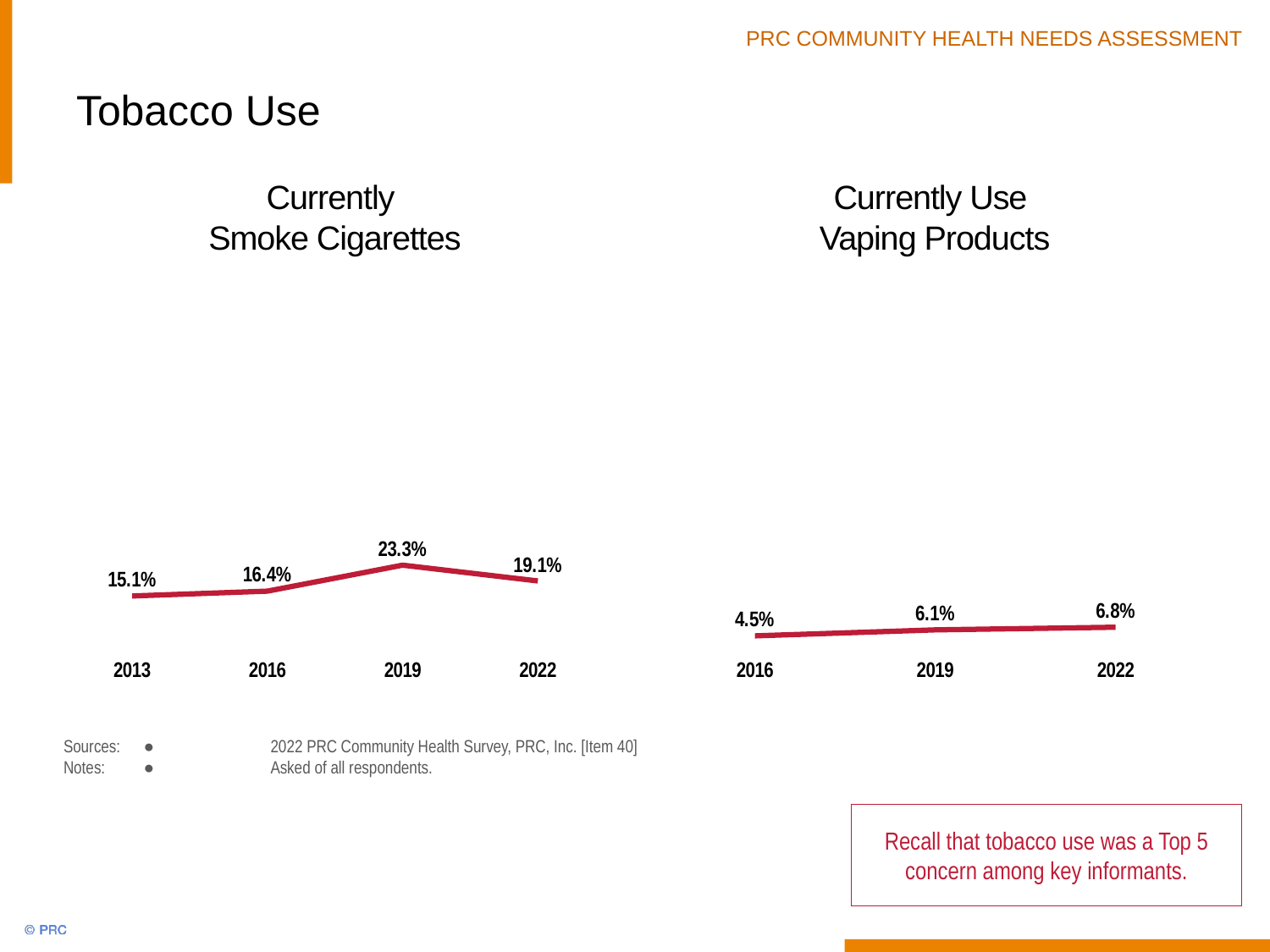
In the 'Currently Smoke Cigarettes' chart, what is the value for 2019? 23.3% In the 'Currently Smoke Cigarettes' chart, what is the value for 2013? 15.1% What kind of chart is the 'Currently Use Vaping Products' chart? Line chart In the 'Currently Use Vaping Products' chart, what is the difference between the 2022 and 2016 values? 2.3% In the 'Currently Smoke Cigarettes' chart, what is the difference between the 2019 and 2022 values? 4.2% In the 'Currently Use Vaping Products' chart, which year has the lowest value? 2016 How many years are plotted in the 'Currently Smoke Cigarettes' chart? 4 In the 'Currently Smoke Cigarettes' chart, which year has the lowest value? 2013 In the 'Currently Use Vaping Products' chart, what is the value for 2022? 6.8% In the 'Currently Smoke Cigarettes' chart, which year has the highest value? 2019 In the 'Currently Smoke Cigarettes' chart, which is larger, the value for 2016 or the value for 2022? 2022 In the 'Currently Use Vaping Products' chart, what is the value for 2016? 4.5%